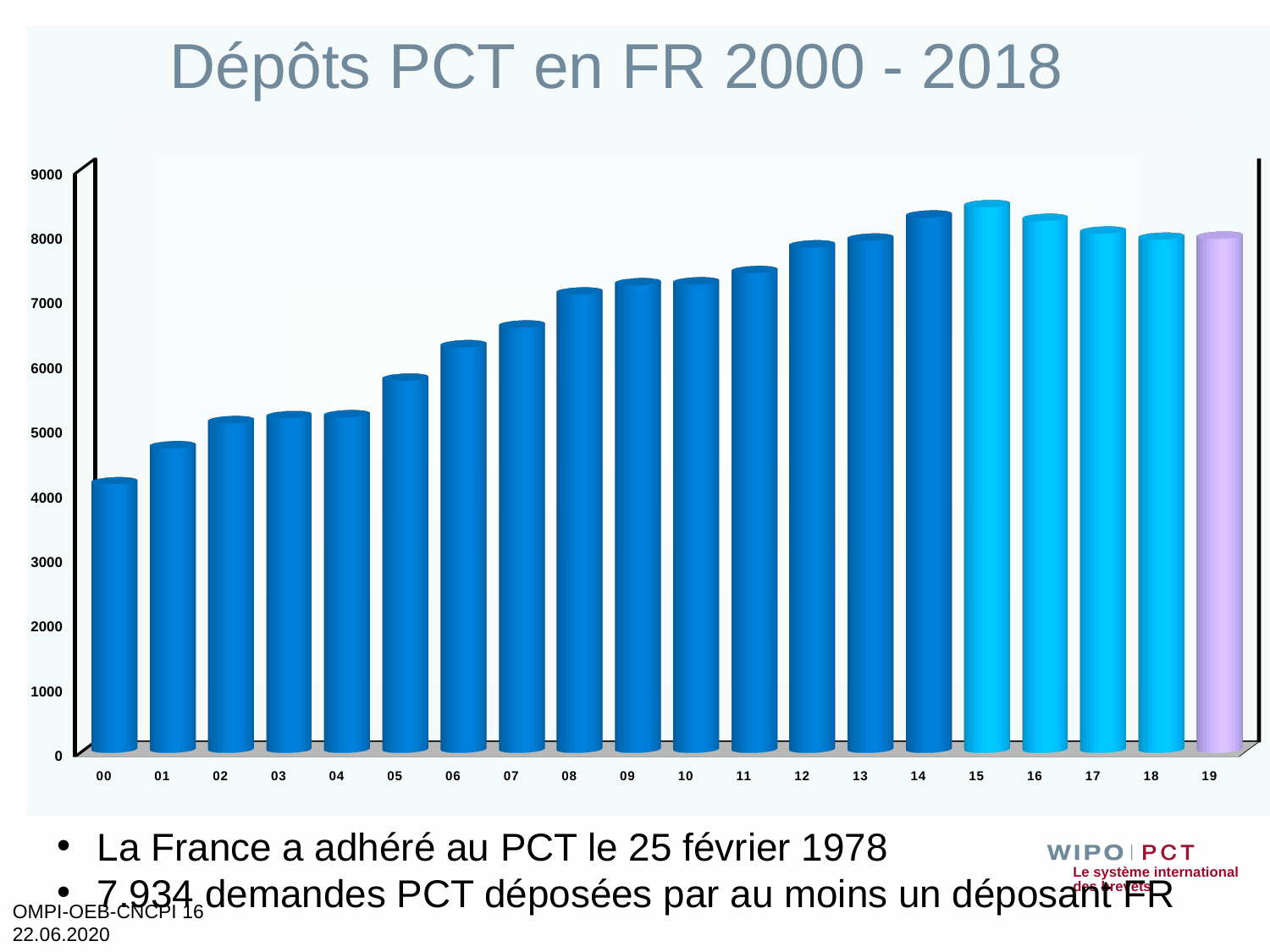
How many bars (years) are plotted in the chart? 20 Do the values rise or fall from 00 to 08 along the x axis? rise Is the value for 05 greater or less than 5000? greater Is the value for 15 greater or less than 8000? greater Is the value for 06 greater or less than 6000? greater What kind of chart is shown on the slide? bar chart Which is larger, the value for 01 or the value for 05? 05 Which year has the lowest bar in the chart? 00 What is the title of the chart? Dépôts PCT en FR 2000 - 2018 Which is larger, the value for 14 or the value for 17? 14 Which year has the highest bar in the chart? 15